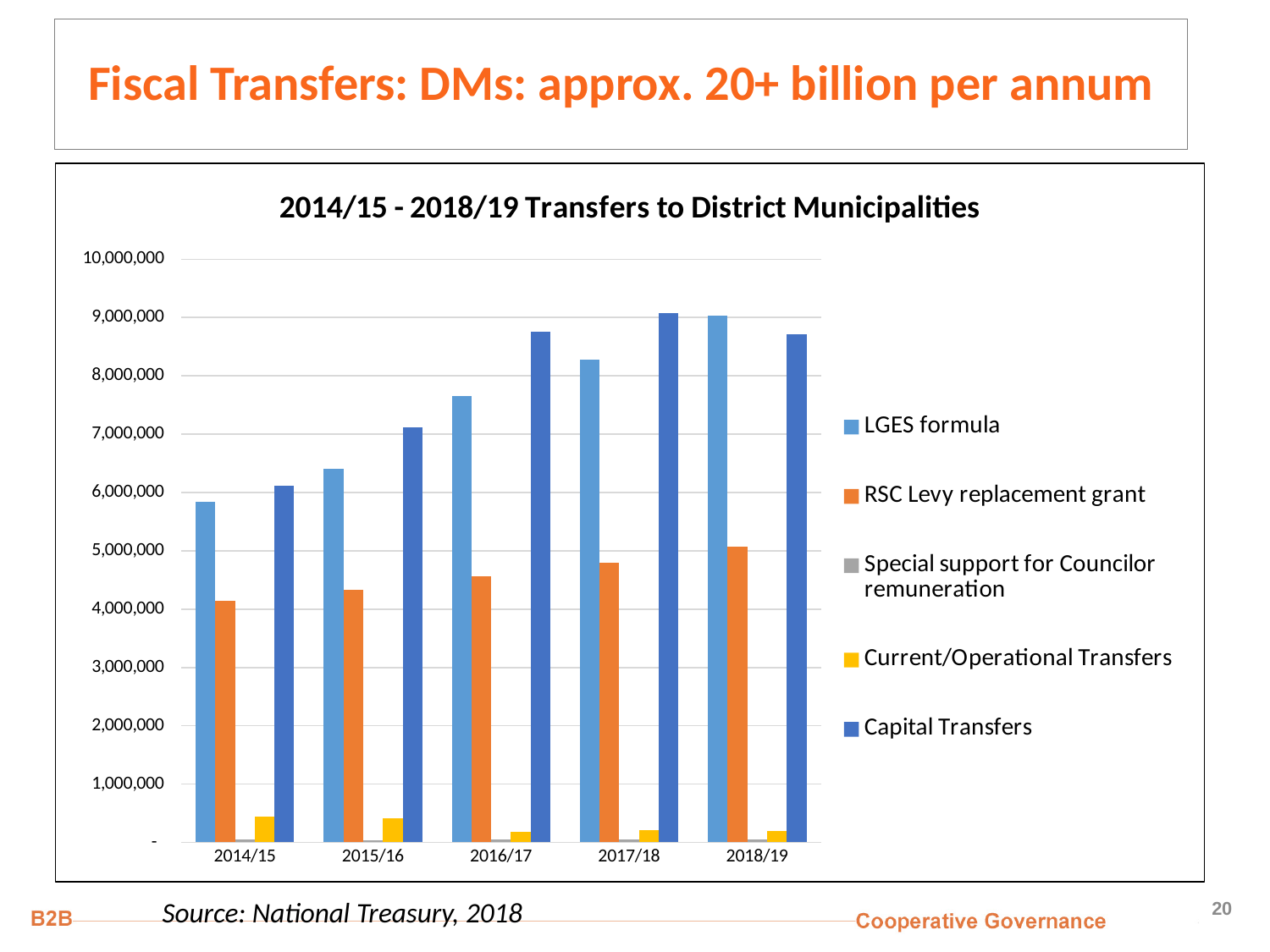
How many financial years are shown on the x axis? 5 Is the RSC Levy replacement grant value for 2018/19 greater or less than 4,000,000? greater How many series does the legend list? 5 What is the title of the chart? 2014/15 - 2018/19 Transfers to District Municipalities In which year is the Capital Transfers value highest? 2017/18 In 2014/15, which is larger: LGES formula or Capital Transfers? Capital Transfers In which year is the LGES formula value lowest? 2014/15 Is the Capital Transfers value for 2016/17 greater or less than 8,000,000? greater What kind of chart is shown on the slide? Bar chart Do the RSC Levy replacement grant values rise or fall from 2014/15 to 2018/19? Rise Do the LGES formula values rise or fall from 2014/15 to 2018/19? Rise Is the LGES formula value for 2014/15 greater or less than 5,000,000? greater